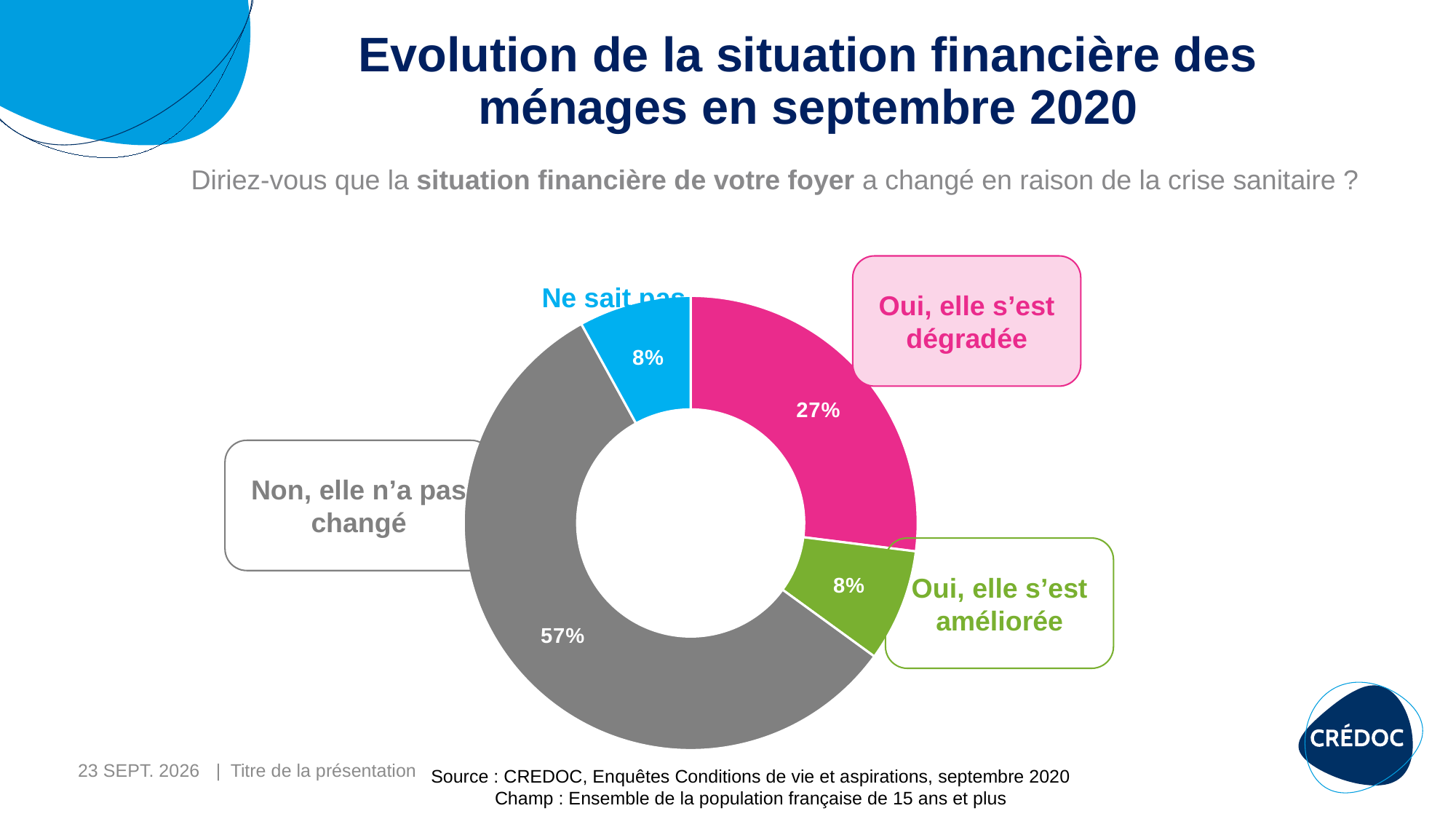
What share of respondents answered "Ne sait pas"? 8% Which response category has the largest share of the pie? Non, elle n'a pas changé Which is larger: the share for "Oui, elle s'est dégradée" or the share for "Oui, elle s'est améliorée"? Oui, elle s'est dégradée What colour is the slice for "Non, elle n'a pas changé"? Grey What is the difference in percentage points between "Non, elle n'a pas changé" and "Oui, elle s'est dégradée"? 30 percentage points What share of respondents said their household's financial situation had not changed ("Non, elle n'a pas changé")? 57% What share of respondents said their household's financial situation had deteriorated ("Oui, elle s'est dégradée")? 27% What colour is the slice for "Oui, elle s'est dégradée"? Pink What kind of chart is shown on the slide? Doughnut chart What is the combined share of respondents who said their situation changed (dégradée plus améliorée)? 35% How many slices does the pie chart have? 4 What share of respondents said their household's financial situation had improved ("Oui, elle s'est améliorée")? 8%